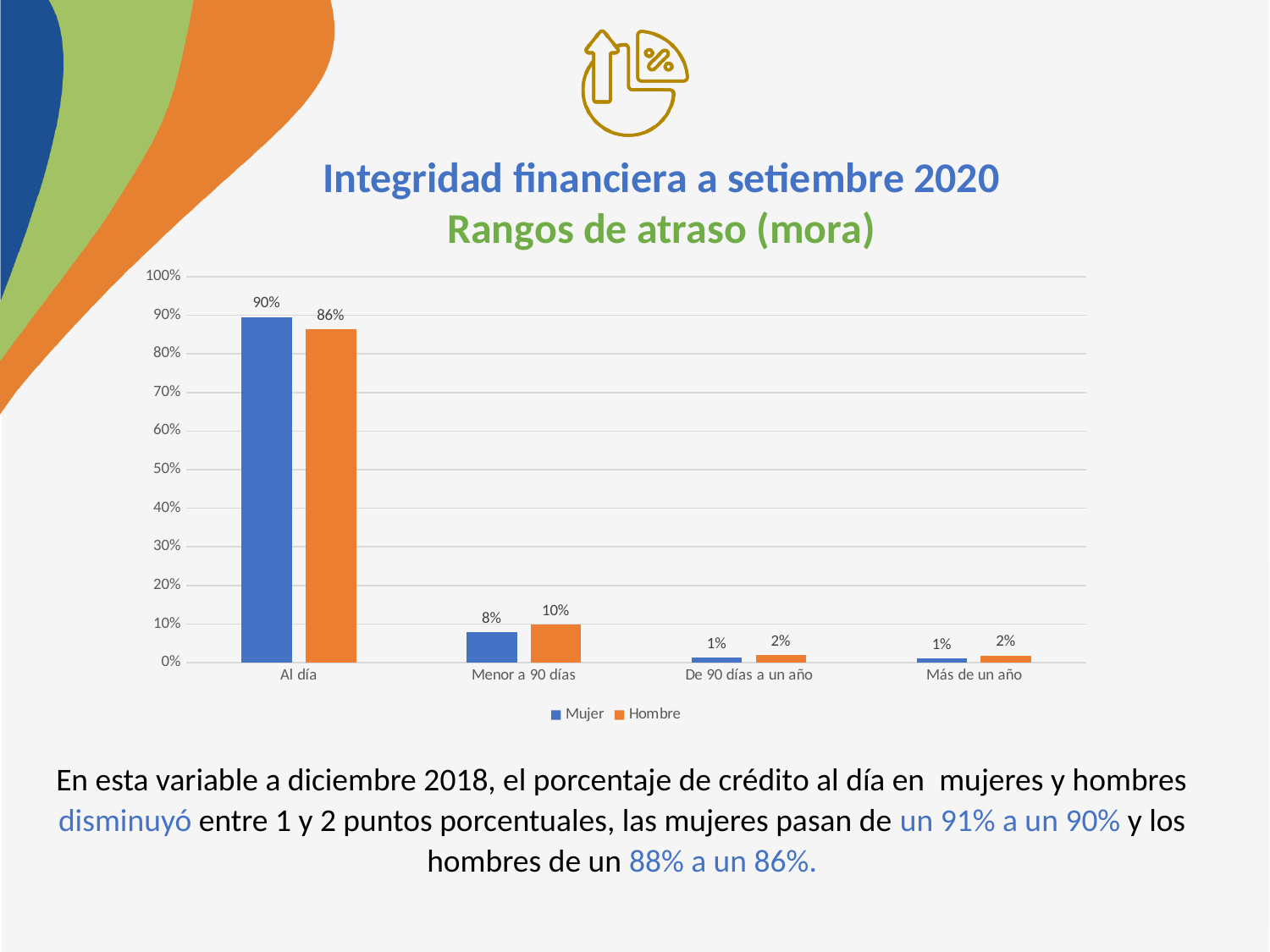
What is the value for Mujer in the 'De 90 días a un año' category? 1% What is the value for Mujer in the 'Al día' category? 90% What is the value for Hombre in the 'Menor a 90 días' category? 10% What kind of chart is shown on the slide? Bar chart What is the value for Hombre in the 'Al día' category? 86% In the 'Menor a 90 días' category, which series has the larger value, Mujer or Hombre? Hombre How many categories are shown on the x axis? 4 What is the difference between the Hombre and Mujer values in the 'Menor a 90 días' category? 2% Which colour represents the Hombre series? Orange How many series does the legend list? 2 What is the difference between the Mujer and Hombre values in the 'Al día' category? 4% Which category has the highest value for Mujer? Al día